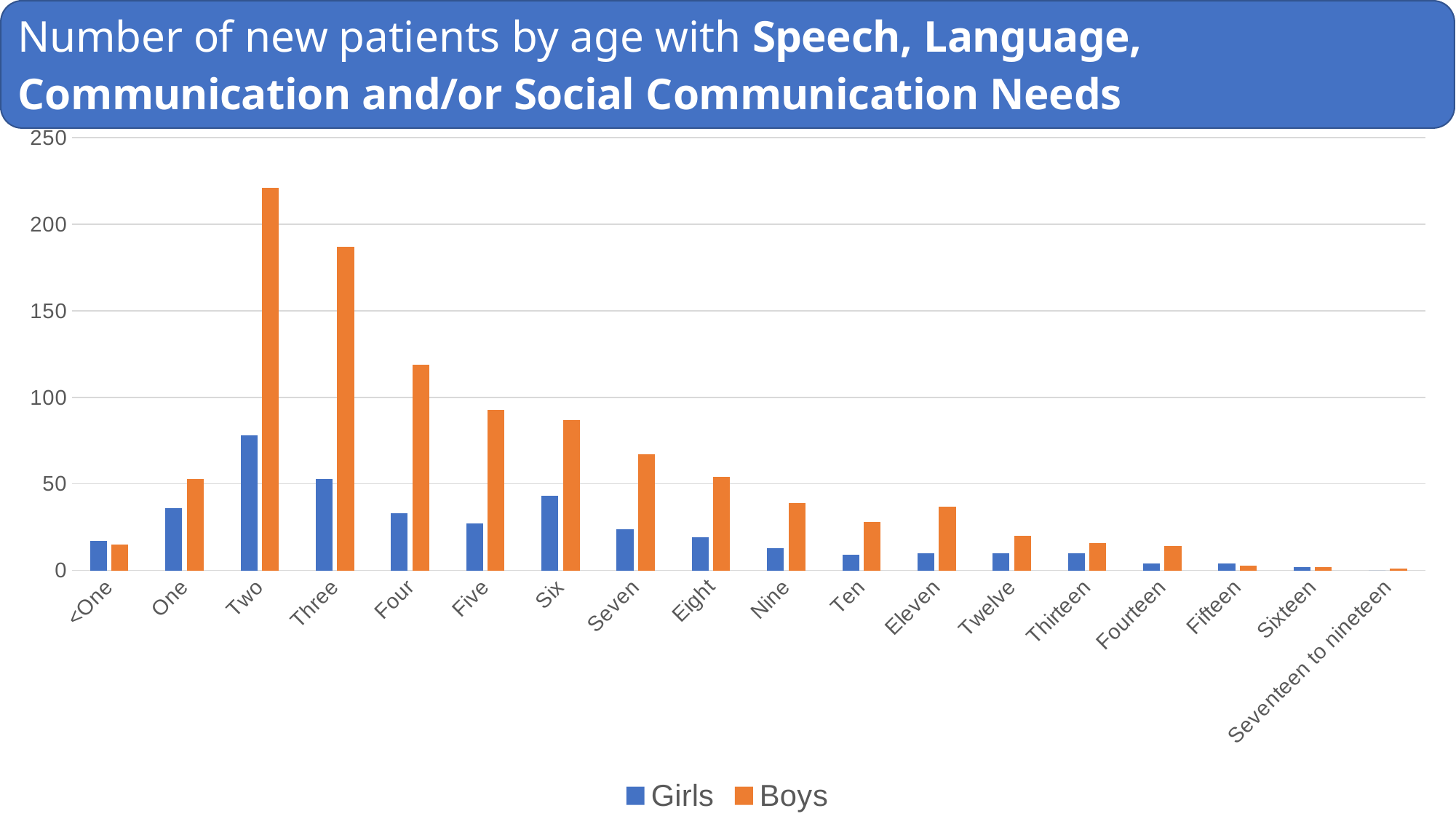
Which age category has the highest number of new Boys patients? Two How many series does the legend list? 2 Is the value for Boys at age Three greater or less than 150? greater At age Six, which series has the larger value, Girls or Boys? Boys Which colour represents the Boys series in the chart? orange How many age categories are shown on the x axis? 18 Is the value for Boys at age Two greater or less than 200? greater Is the value for Boys at age Four greater or less than 100? greater What type of chart is shown on the slide? bar chart Which age category has the highest number of new Girls patients? Two